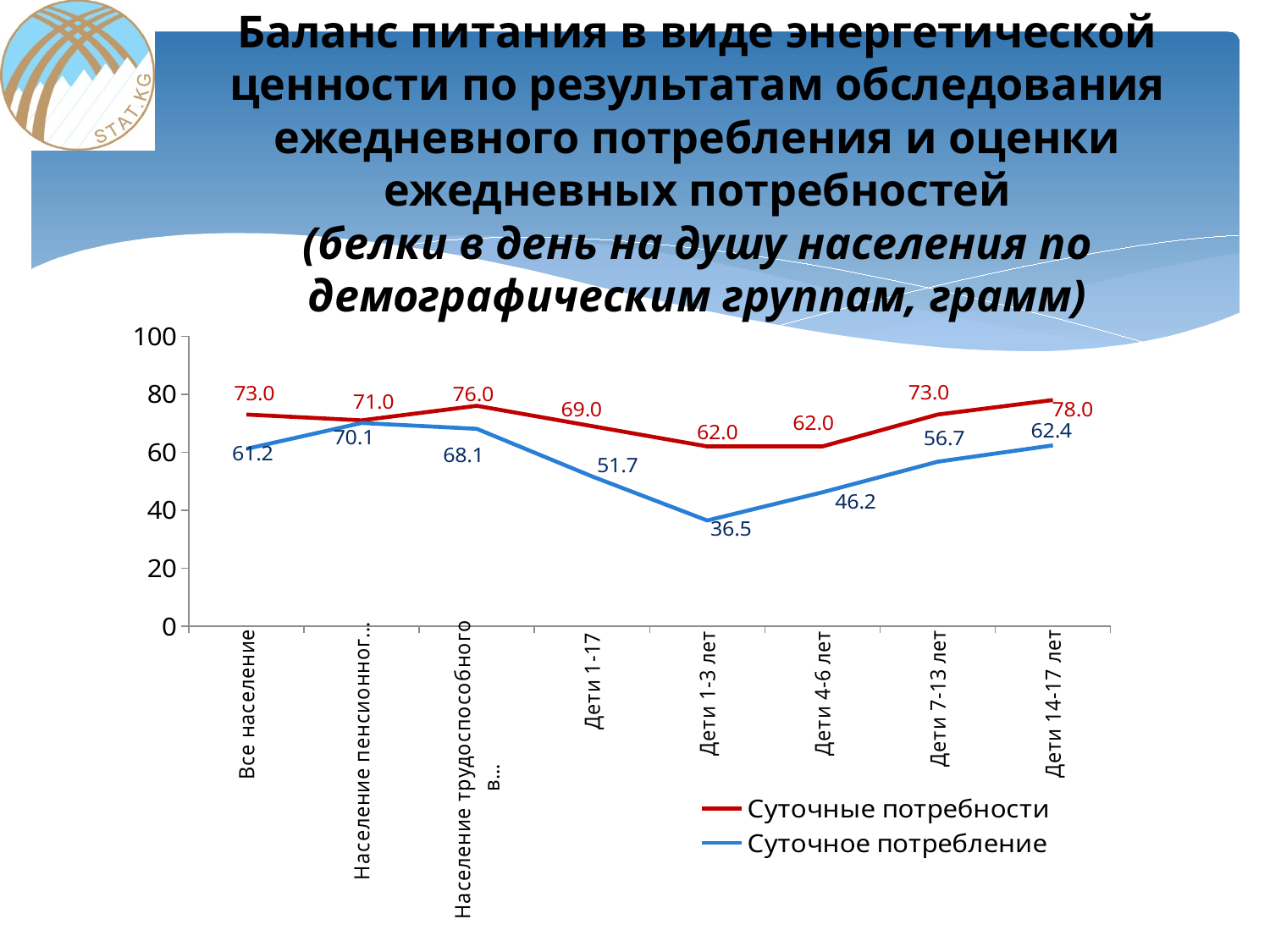
What is the value of Суточное потребление for Дети 1-3 лет? 36.5 What is the value of Суточные потребности for Дети 1-17? 69.0 Which category has the lowest value for Суточное потребление? Дети 1-3 лет Which category has the highest value for Суточные потребности? Дети 14-17 лет For Дети 4-6 лет, which series has the larger value, Суточные потребности or Суточное потребление? Суточные потребности How many categories are plotted along the x axis? 8 What is the value of Суточное потребление for Все население? 61.2 Is the value of Суточное потребление for Дети 7-13 лет greater or less than 60? less What colour is the line for Суточные потребности? red How many series does the legend list? 2 What is the difference between Суточные потребности and Суточное потребление for Дети 1-3 лет? 25.5 What kind of chart is shown on the slide? line chart